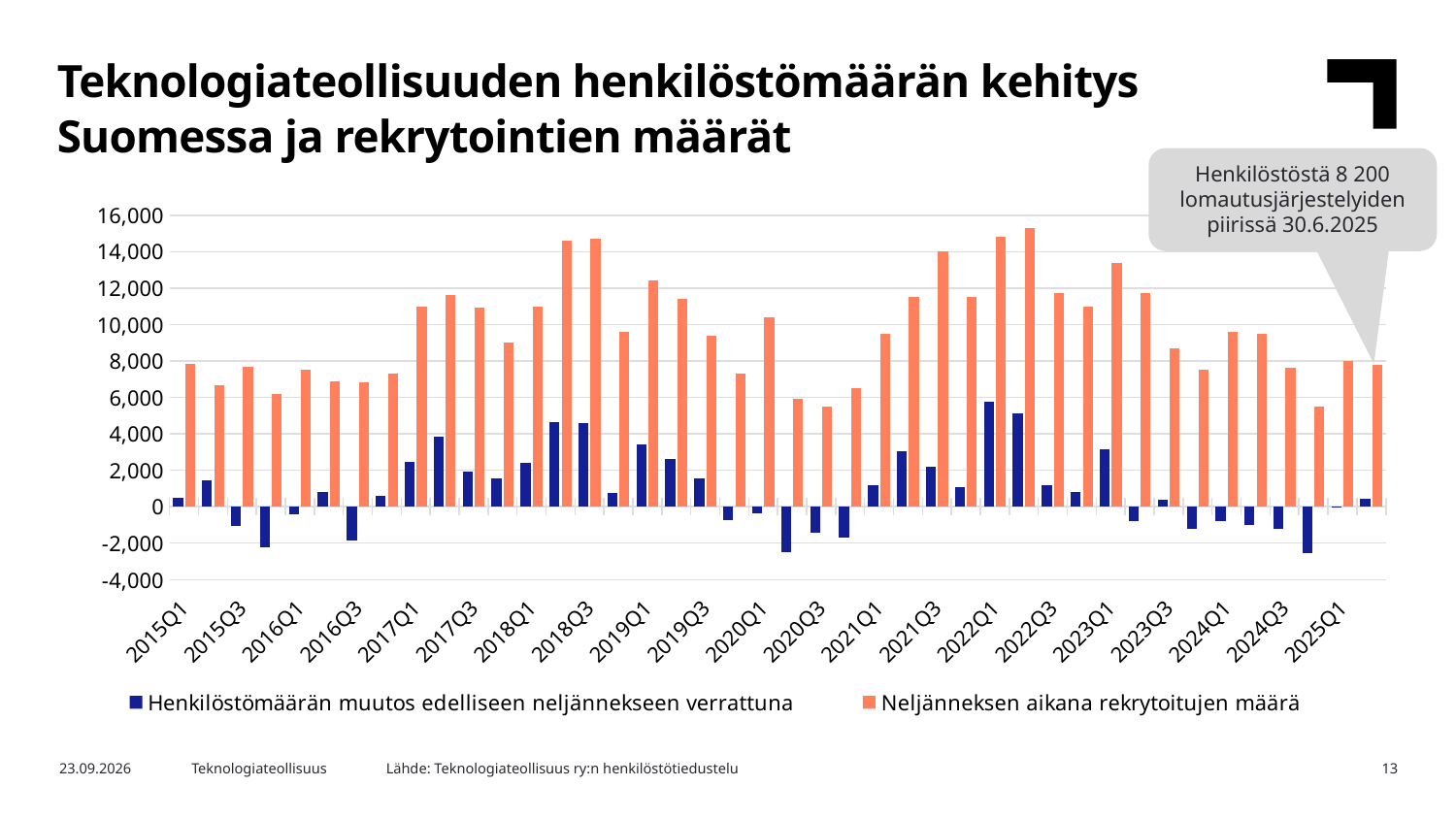
Which series is shown in orange according to the legend? Neljänneksen aikana rekrytoitujen määrä Is the headcount change (Henkilöstömäärän muutos edelliseen neljännekseen verrattuna) in 2022Q1 greater or less than 4,000? greater Is the number of recruits (Neljänneksen aikana rekrytoitujen määrä) in 2018Q3 greater or less than 12,000? greater In which quarter is the headcount change compared to the previous quarter the highest? 2022Q1 Is the number of recruits in 2015Q1 greater or less than 10,000? less According to the callout on the slide, how many employees were covered by lay-off arrangements on 30.6.2025? 8 200 What kind of chart is shown on the slide? bar chart How many series does the legend list? 2 Which quarter has more recruits, 2016Q1 or 2017Q1? 2017Q1 Which quarter has a larger headcount change, 2018Q2 or 2019Q1? 2018Q2